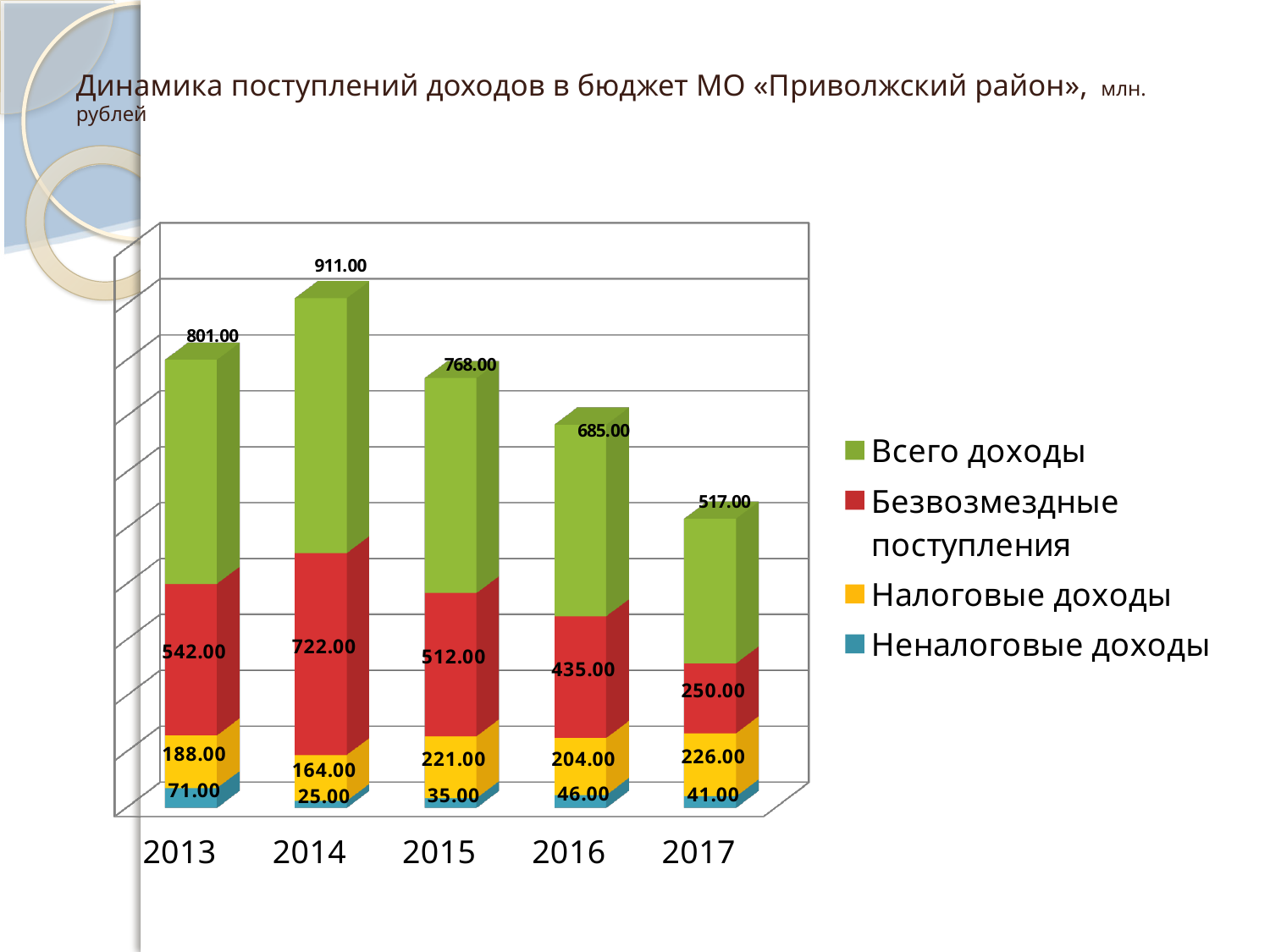
What is the value of Всего доходы for 2014? 911.00 In which year is Неналоговые доходы the lowest? 2014 How many years are shown on the x axis? 5 How many series does the legend list? 4 What is the value of Безвозмездные поступления for 2016? 435.00 Which is larger: Налоговые доходы in 2015 or in 2016? 2015 What kind of chart is shown on the slide? Stacked bar chart What is the value of Налоговые доходы for 2017? 226.00 Does Всего доходы rise or fall from 2014 to 2017? Fall What is the difference between Всего доходы in 2013 and in 2017? 284.00 What is the value of Неналоговые доходы for 2013? 71.00 In which year is Всего доходы the highest? 2014